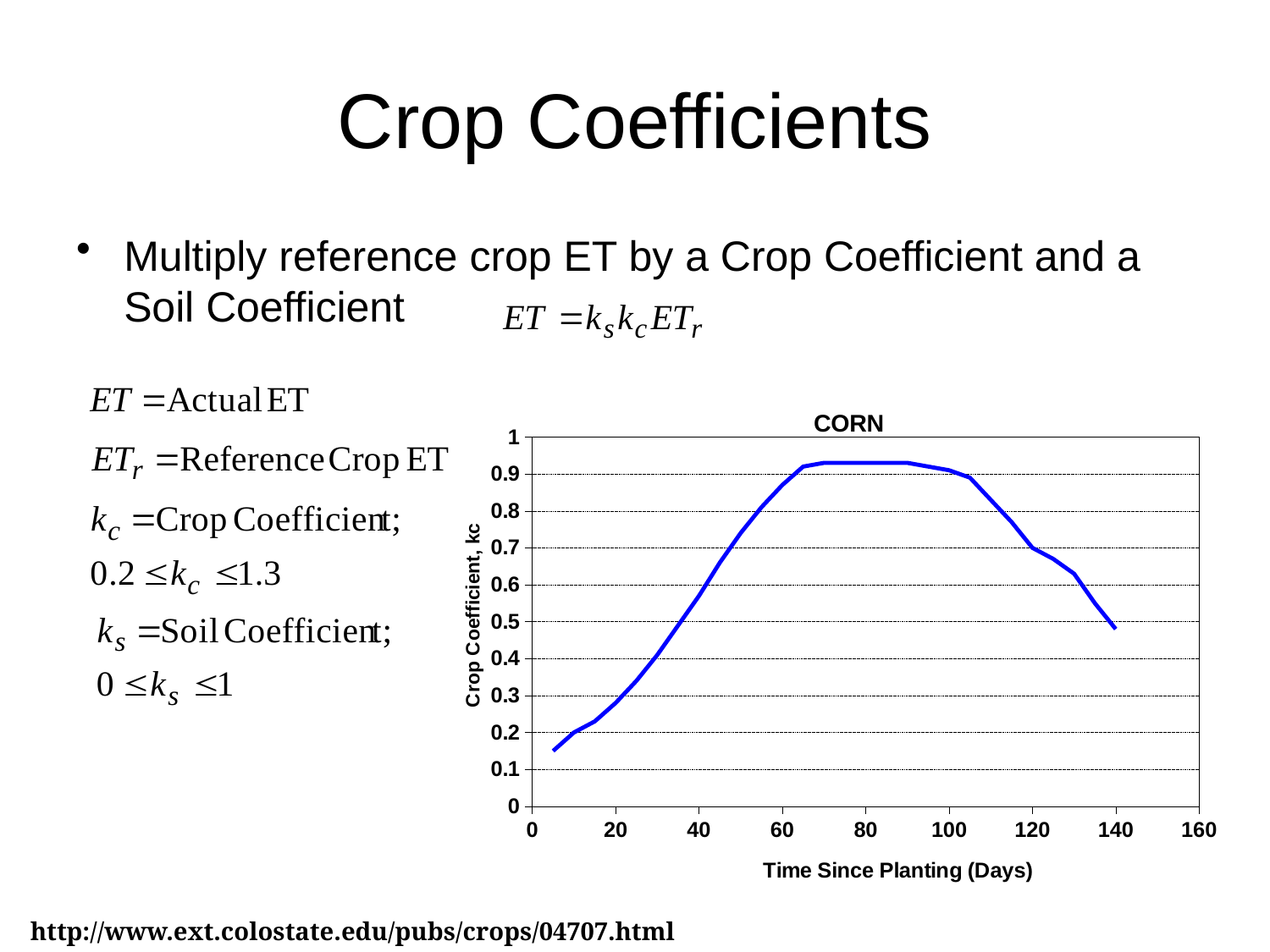
Is the crop coefficient at the first plotted point (about 5 days) greater or less than 0.2? less Does the crop coefficient rise or fall between 100 and 140 days since planting? fall What is the title of the chart? CORN Is the crop coefficient at 130 days since planting greater or less than 0.6? greater Which is larger, the crop coefficient at 80 days or at 140 days since planting? 80 days Which is larger, the crop coefficient at 20 days or at 60 days since planting? 60 days What is the label of the x axis of the chart? Time Since Planting (Days) What kind of chart is shown on the slide? line chart Is the crop coefficient at 80 days since planting greater or less than 0.9? greater Does the crop coefficient rise or fall between 0 and 60 days since planting? rise